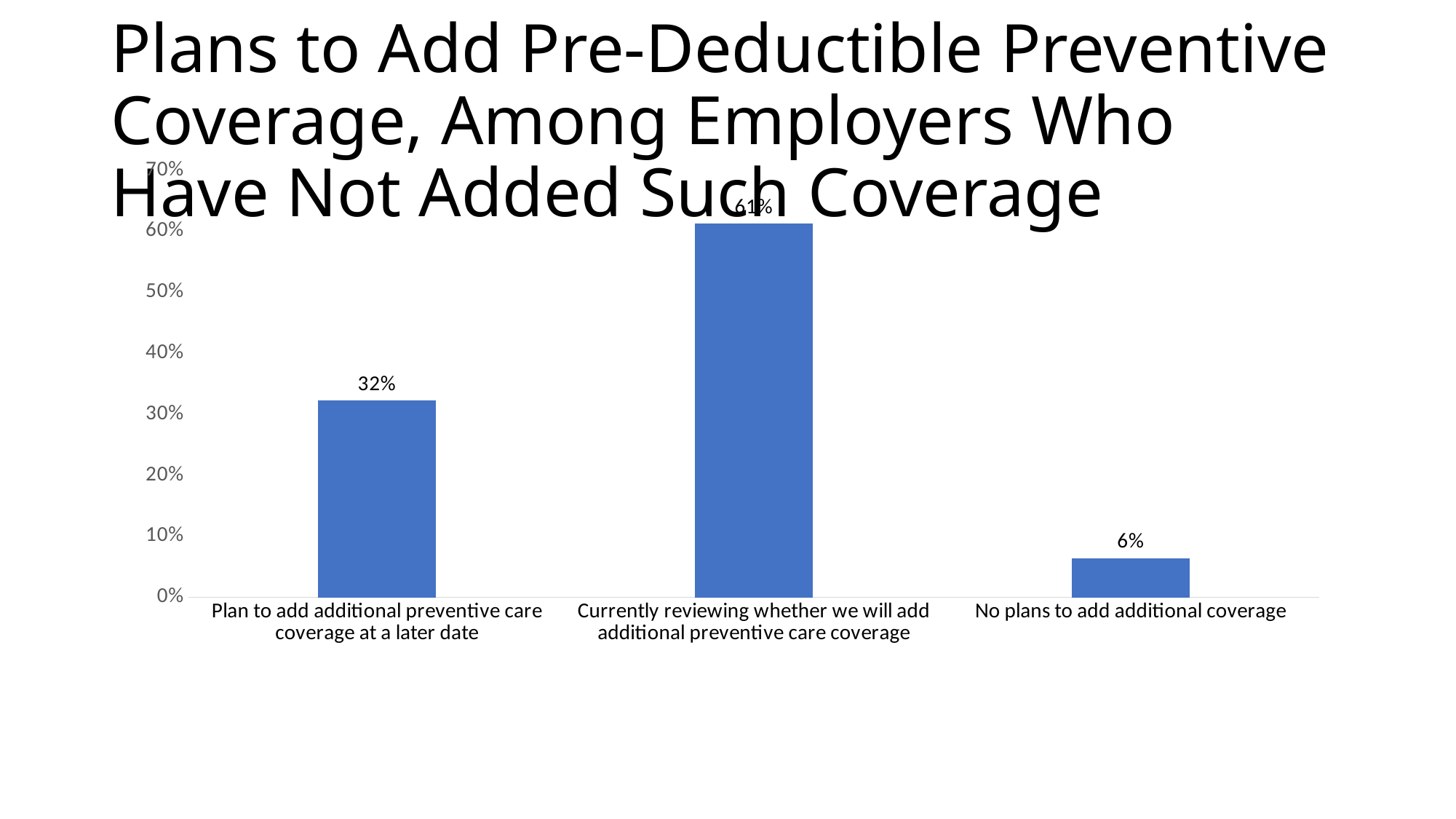
Is the value for 'No plans to add additional coverage' greater or less than 10%? less What percentage of employers have no plans to add additional coverage? 6% Which category has the lowest value? No plans to add additional coverage Which category has the highest value? Currently reviewing whether we will add additional preventive care coverage What is the difference between the value for 'Plan to add additional preventive care coverage at a later date' and 'No plans to add additional coverage'? 26% Is the value for 'Currently reviewing whether we will add additional preventive care coverage' greater or less than 50%? greater What percentage of employers plan to add additional preventive care coverage at a later date? 32% How many categories are shown in the chart? 3 What colour are the bars in the chart? Blue Which is larger: the value for 'Plan to add additional preventive care coverage at a later date' or 'No plans to add additional coverage'? Plan to add additional preventive care coverage at a later date What kind of chart is shown on the slide? Bar chart What is the highest value shown on the vertical axis? 70%